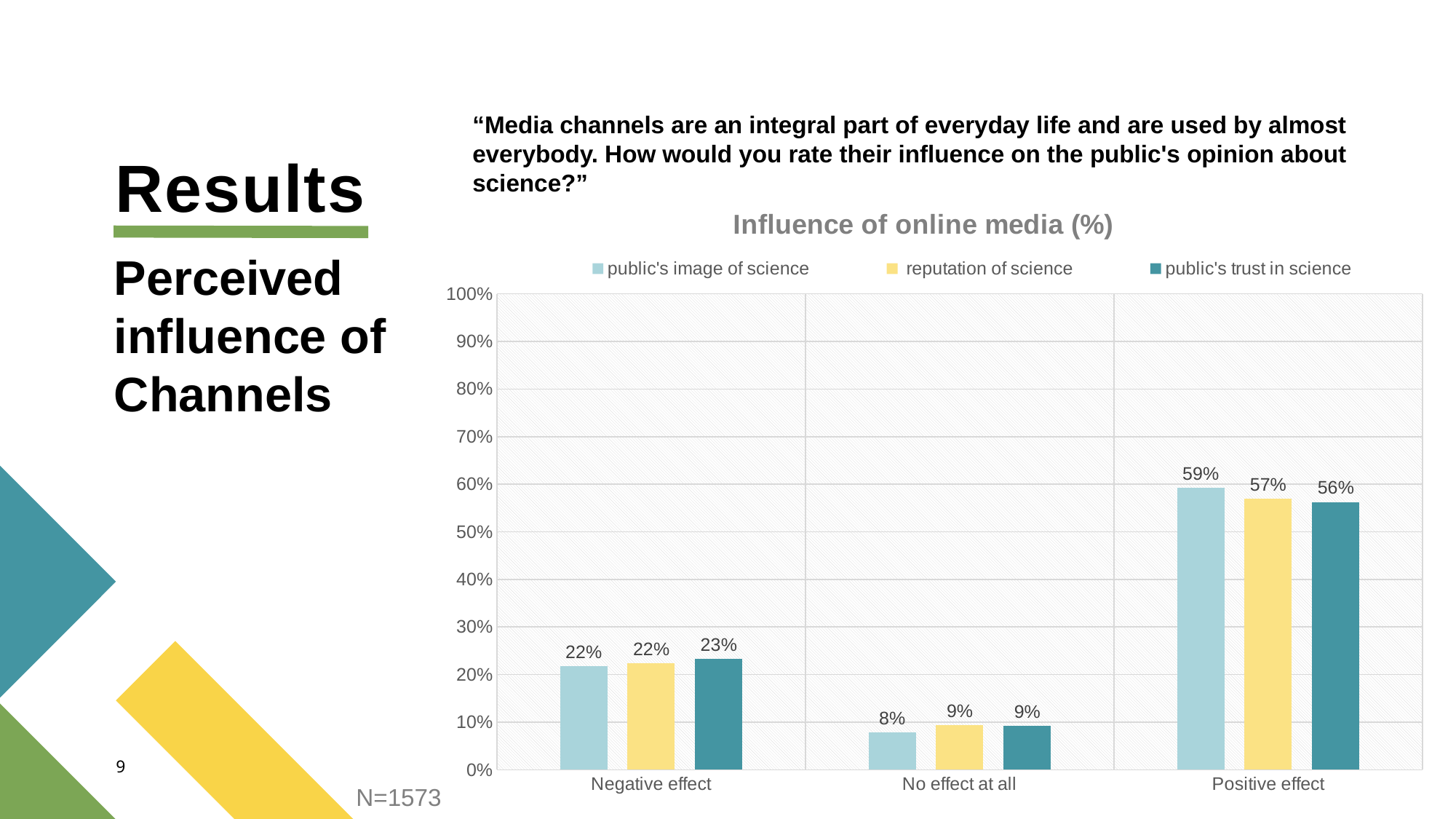
What kind of chart is shown on the slide? bar chart Is the value for "reputation of science" in the "Positive effect" category greater or less than 50%? greater What is the value for "reputation of science" in the "No effect at all" category? 9% What is the title of the chart? Influence of online media (%) Which category has the lowest value for "public's image of science"? No effect at all What is the difference between the "public's image of science" value and the "public's trust in science" value in the "Positive effect" category? 3% How many categories are shown on the x axis? 3 What is the value for "public's trust in science" in the "Negative effect" category? 23% How many series does the legend list? 3 What is the value for "public's image of science" in the "Positive effect" category? 59% Which category has the highest value for "public's trust in science"? Positive effect In the "Positive effect" category, which is larger: "public's image of science" or "public's trust in science"? public's image of science